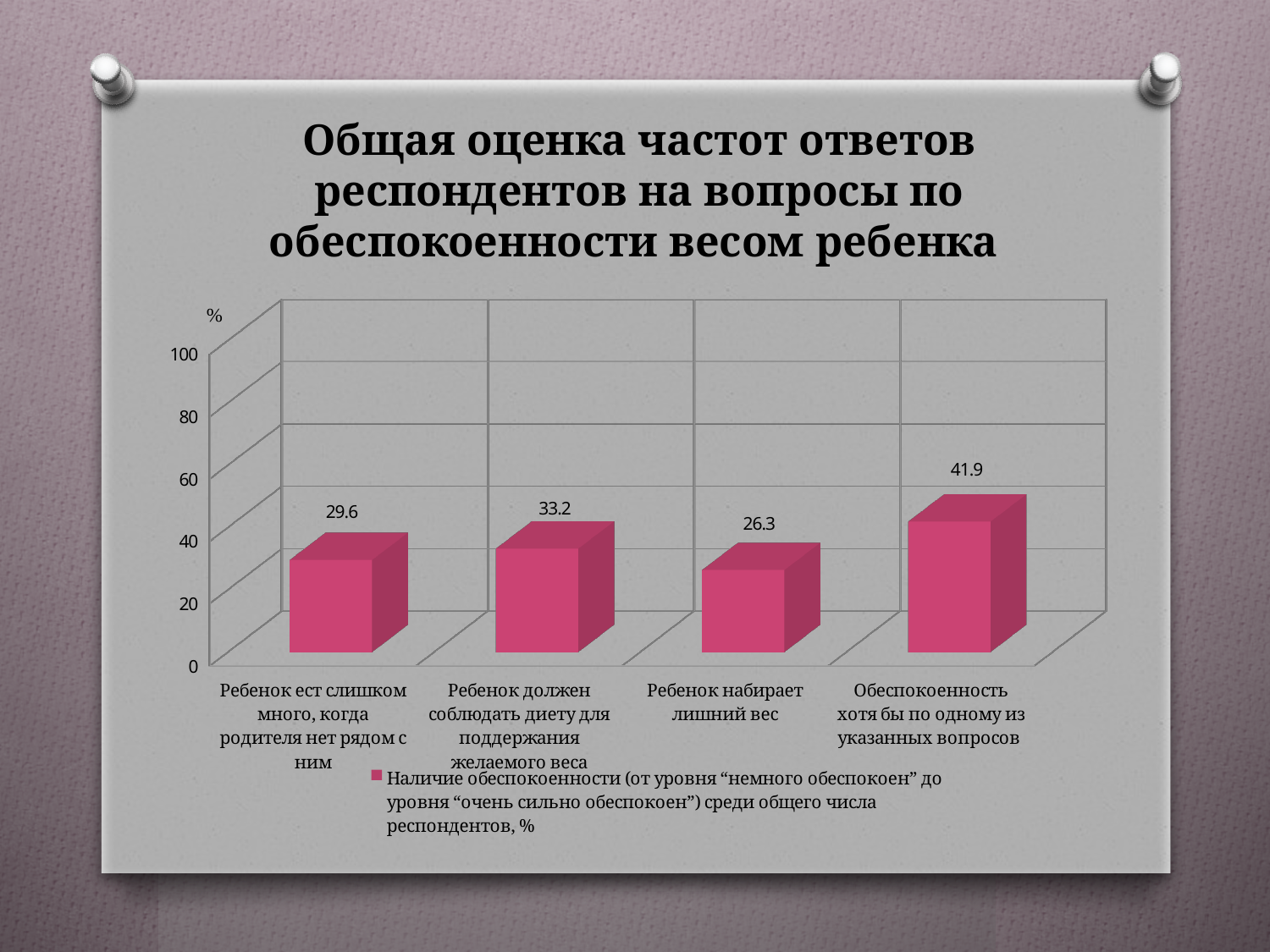
What kind of chart is shown on the slide? bar chart What is the value for "Обеспокоенность хотя бы по одному из указанных вопросов"? 41.9 Which is larger: the value for "Ребенок должен соблюдать диету для поддержания желаемого веса" or for "Ребенок ест слишком много, когда родителя нет рядом с ним"? Ребенок должен соблюдать диету для поддержания желаемого веса What unit is indicated on the vertical axis of the chart? % Which category has the lowest value? Ребенок набирает лишний вес How many categories are shown in the chart? 4 What is the value for "Ребенок должен соблюдать диету для поддержания желаемого веса"? 33.2 What is the difference between the values for "Обеспокоенность хотя бы по одному из указанных вопросов" and "Ребенок набирает лишний вес"? 15.6 Is the value for "Обеспокоенность хотя бы по одному из указанных вопросов" greater or less than 40? greater What is the value for "Ребенок набирает лишний вес"? 26.3 Which category has the highest value? Обеспокоенность хотя бы по одному из указанных вопросов What is the value for "Ребенок ест слишком много, когда родителя нет рядом с ним"? 29.6